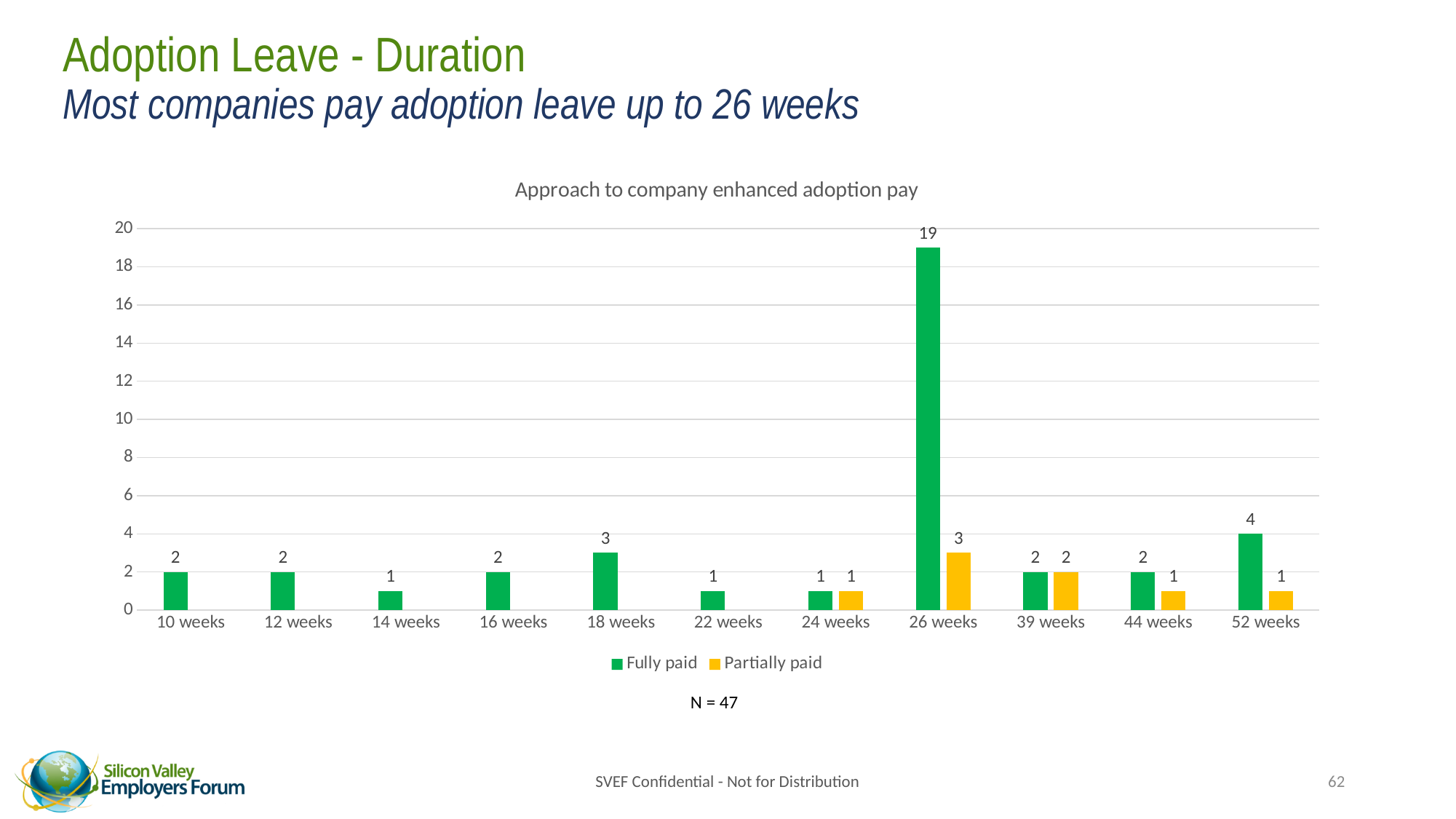
Which category has the highest Partially paid value? 26 weeks What is the Partially paid value for 39 weeks? 2 What is the difference between the Fully paid and Partially paid values for 26 weeks? 16 What is the Fully paid value for 52 weeks? 4 How many categories are shown on the x axis? 11 What is the Fully paid value for 26 weeks? 19 Which is larger for 44 weeks, the Fully paid value or the Partially paid value? Fully paid What is the title of the chart? Approach to company enhanced adoption pay How many series does the legend list? 2 What kind of chart is shown? Bar chart Which category has the highest Fully paid value? 26 weeks Is the Fully paid value for 26 weeks greater or less than 10? greater